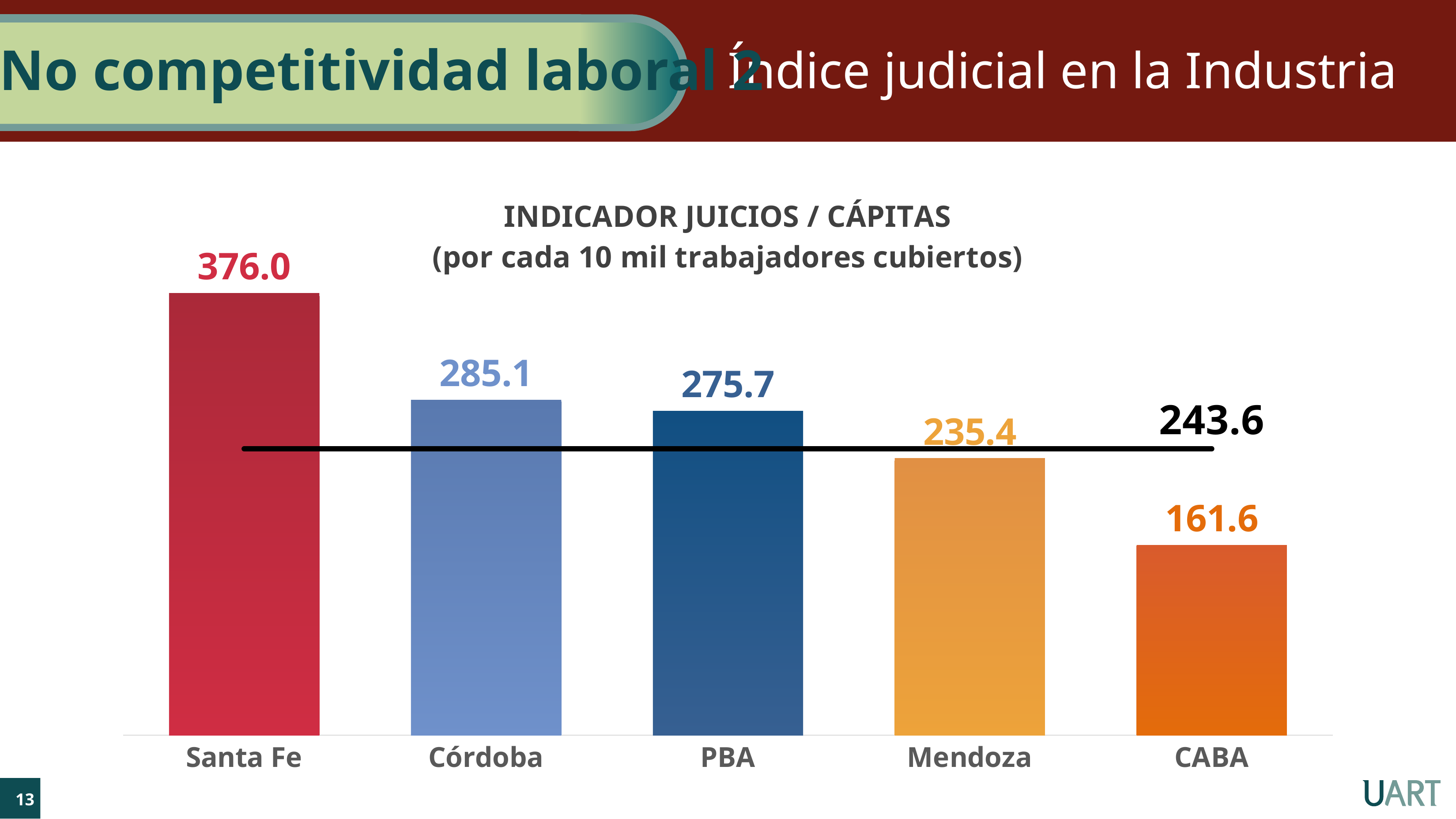
Which is larger, the value for Córdoba or the value for Mendoza? Córdoba Which category has the highest value? Santa Fe What is the value for PBA? 275.7 What value is labelled on the horizontal reference line across the chart? 243.6 Which category has the lowest value? CABA What is the value for Santa Fe? 376.0 How many categories are shown in the chart? 5 What is the value for Córdoba? 285.1 What is the value for CABA? 161.6 What is the difference between the values for Santa Fe and CABA? 214.4 What kind of chart is shown on the slide? Bar chart What is the value for Mendoza? 235.4